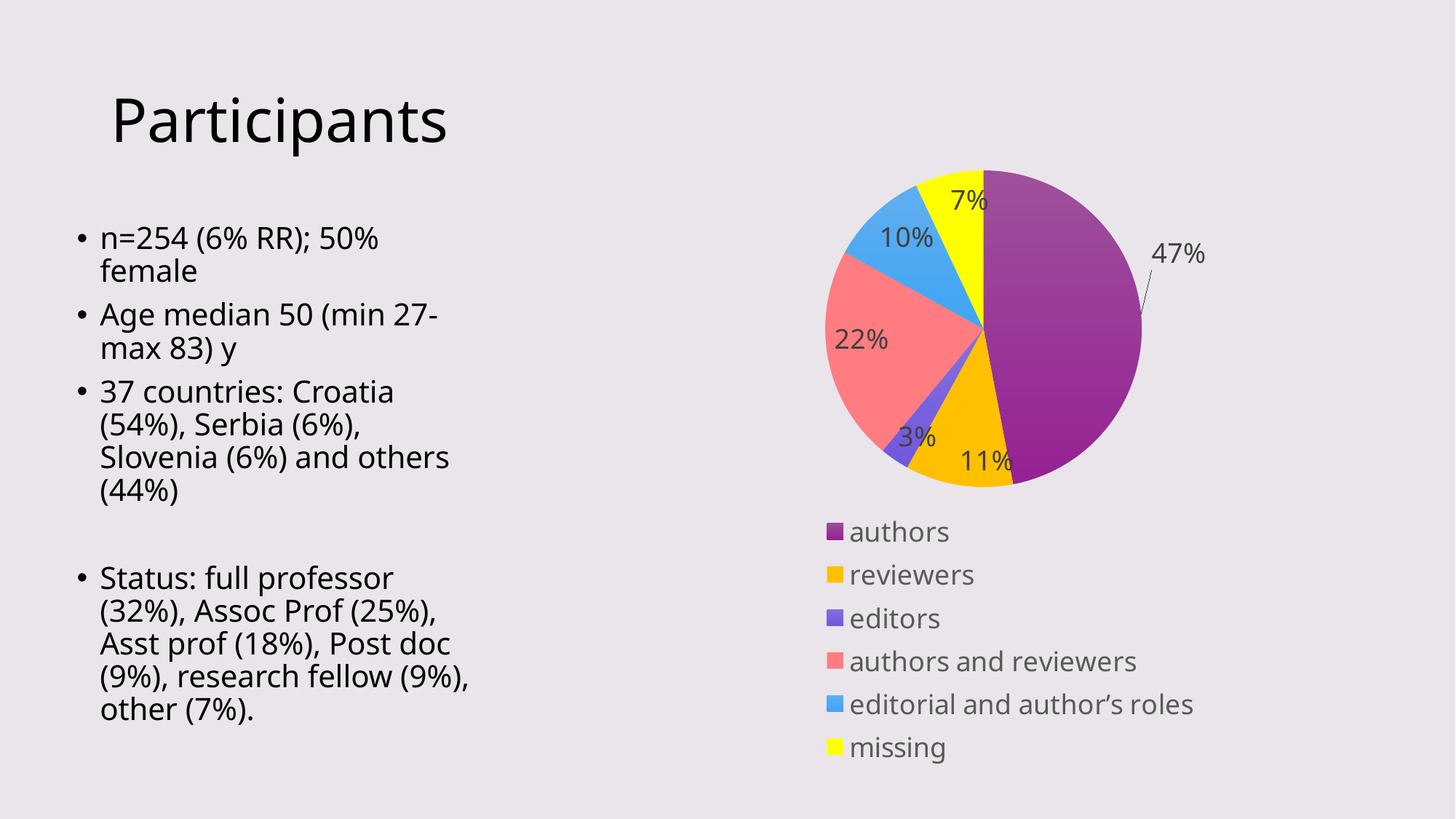
What share of the pie is labelled for authors? 47% Which slice is larger: reviewers or editorial and author's roles? reviewers What share of the pie is labelled for reviewers? 11% What kind of chart is shown on the slide? pie chart What is the difference in percentage points between the authors slice and the authors and reviewers slice? 25 Which category has the smallest slice of the pie? editors What share of the pie is labelled for missing? 7% What share of the pie is labelled for editorial and author's roles? 10% How many categories does the legend of the pie chart list? 6 Which category has the largest slice of the pie? authors What share of the pie is labelled for editors? 3% What share of the pie is labelled for authors and reviewers? 22%